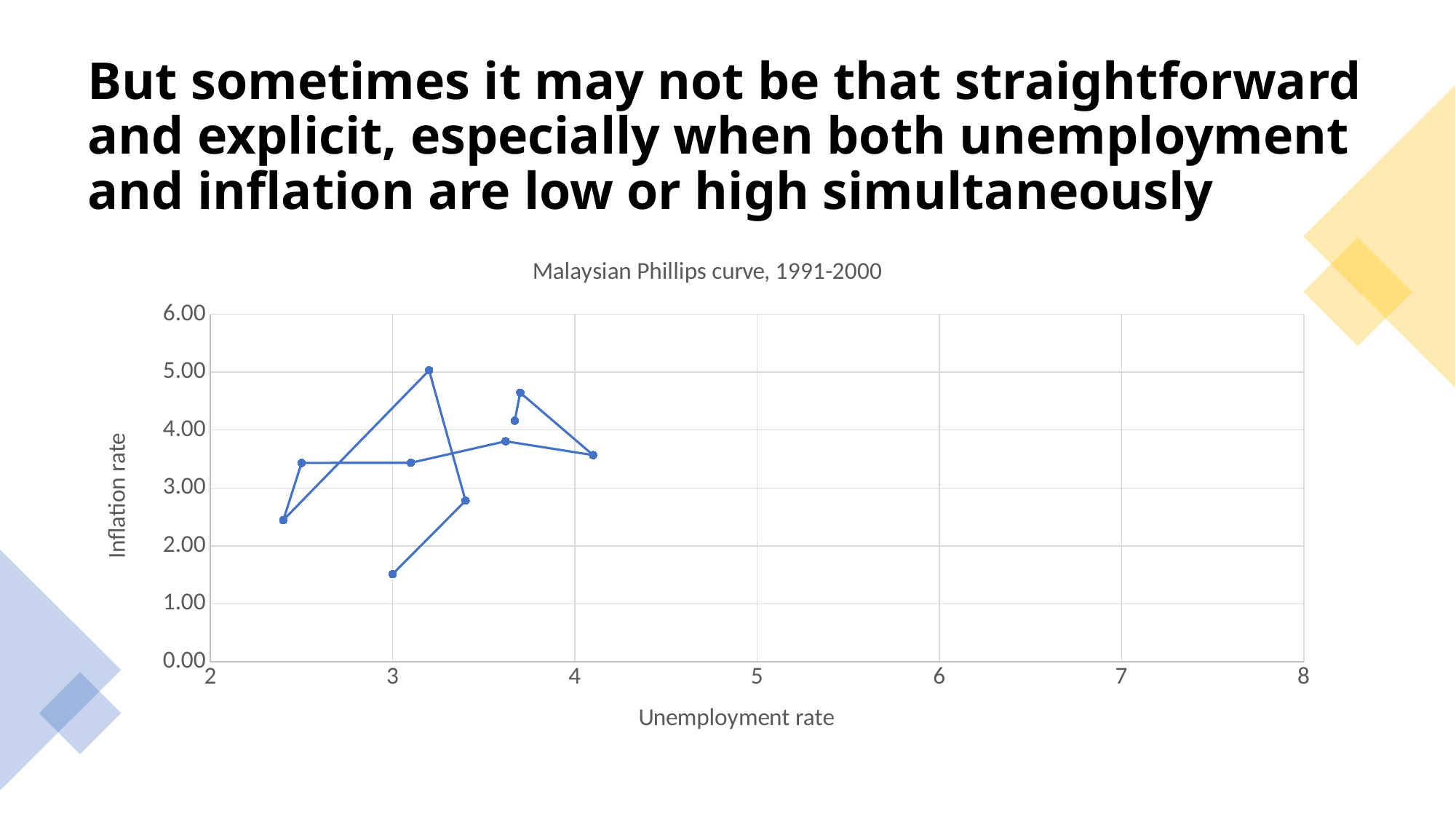
What is the label of the horizontal axis? Unemployment rate What is the maximum value shown on the vertical axis? 6.00 Is the highest inflation rate plotted on the chart greater or less than 4.00? greater What kind of chart is shown on the slide? scatter chart with connected points What is the title of the chart? Malaysian Phillips curve, 1991-2000 How many data points are plotted on the chart? 10 Is the lowest inflation rate plotted on the chart greater or less than 2.00? less Are all plotted inflation rates greater or less than 6.00? less